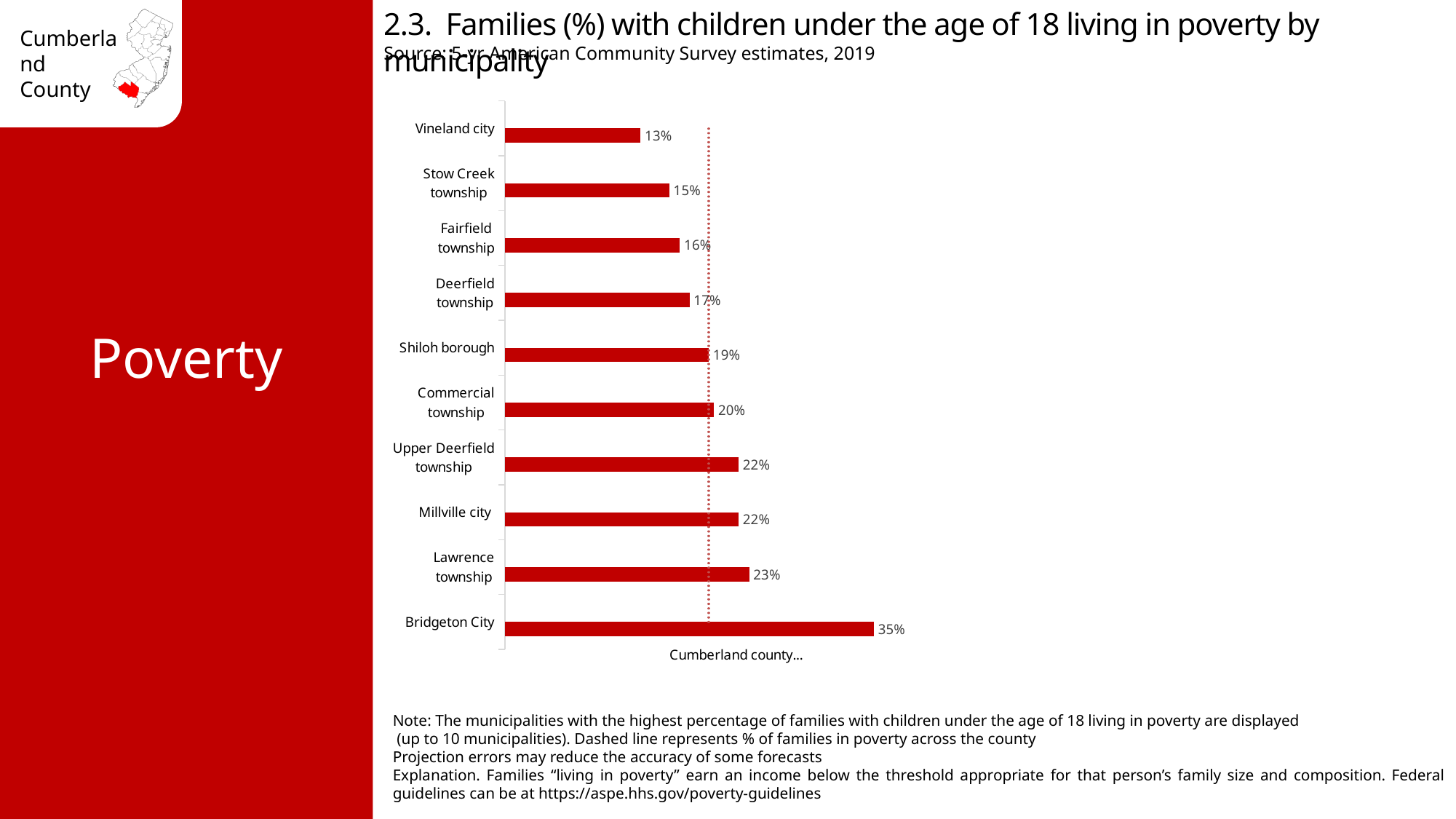
What kind of chart is shown on the slide? Bar chart Which is larger, the value for Commercial township or the value for Deerfield township? Commercial township What is the value for Lawrence township? 23% What is the value for Vineland city? 13% What is the difference between the values for Bridgeton City and Vineland city? 22% What is the value for Bridgeton City? 35% What does the dotted vertical line on the chart represent? % of families in poverty across Cumberland county How many municipalities are shown on the chart? 10 What is the difference between the values for Lawrence township and Stow Creek township? 8% Which municipality has the lowest percentage shown on the chart? Vineland city Which municipality has the highest percentage of families with children under 18 living in poverty? Bridgeton City What is the value for Shiloh borough? 19%